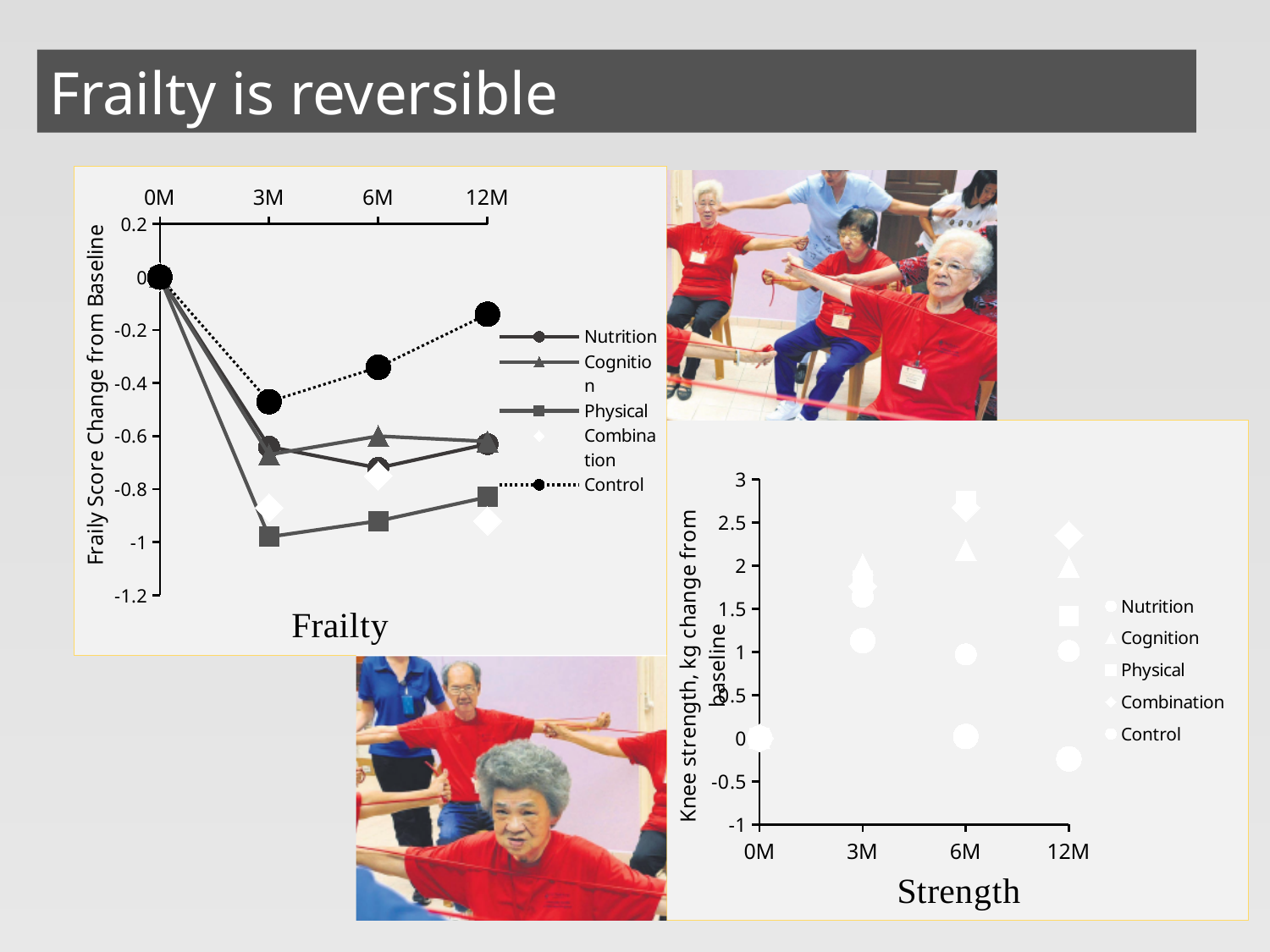
What is the y-axis label of the Frailty chart? Fraily Score Change from Baseline In the Frailty chart, which series has the highest value at 3M? Control What kind of chart is the Strength chart? scatter chart In the Frailty chart, does the Control series rise or fall from 3M to 12M? rise What kind of chart is the Frailty chart? line chart In the Strength chart, which series has the lowest value at 12M? Control In the Strength chart, is the value for Control at 12M greater or less than 0? less In the Frailty chart, is the value for Control at 12M greater or less than -0.2? greater In the Frailty chart, is the value for Control at 3M greater or less than -0.4? less How many series does the legend of the Frailty chart list? 5 In the Frailty chart, which series has the lowest value at 3M? Physical How many time points are shown on the x axis of the Strength chart? 4